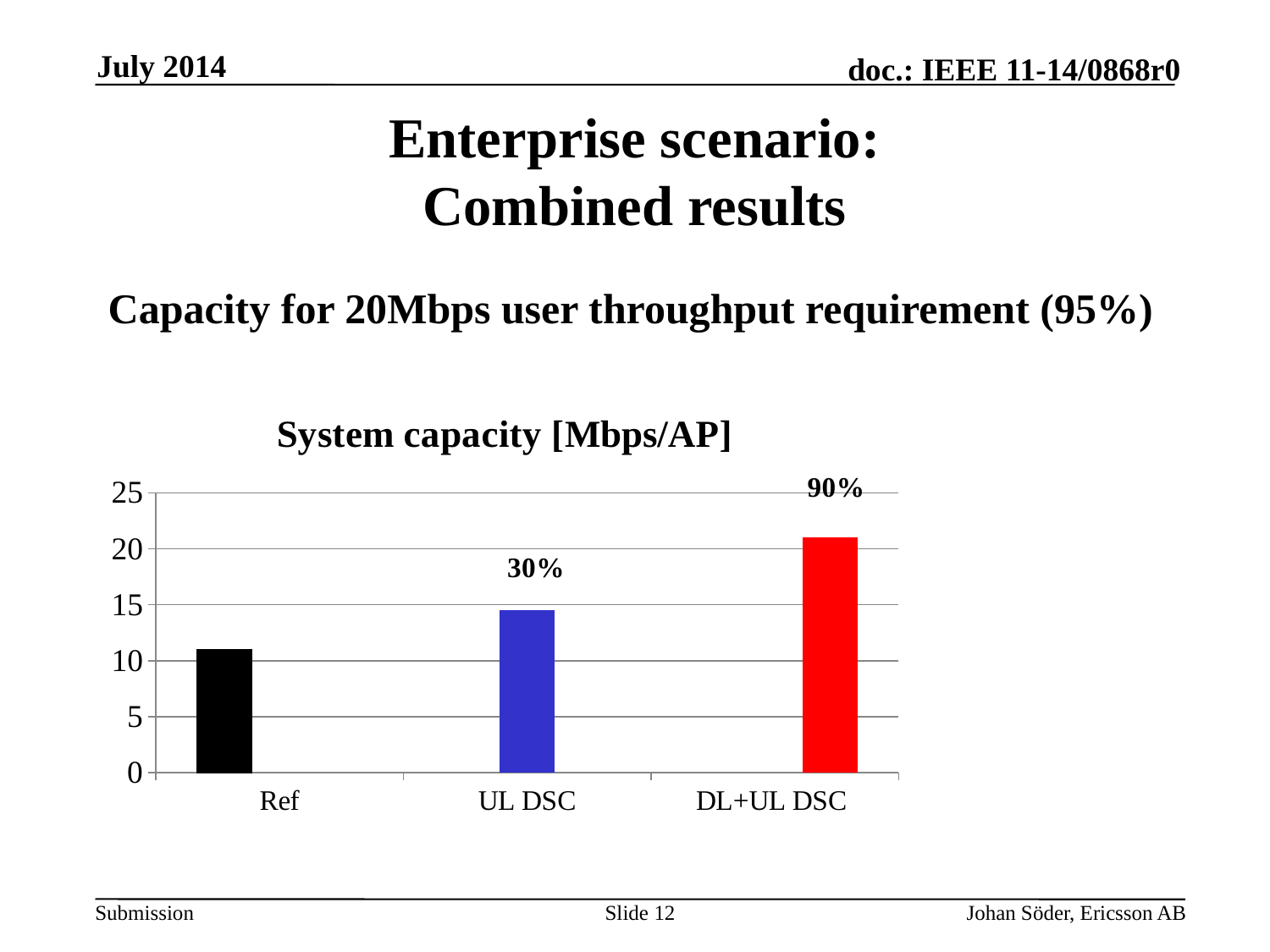
Is the value for Ref greater or less than 15? less What type of chart is shown on the slide? bar chart Is the value for UL DSC greater or less than 10? greater Do the values rise or fall from Ref to DL+UL DSC along the x axis? rise Which category has the highest system capacity? DL+UL DSC What percentage label is printed above the DL+UL DSC bar? 90% What percentage label is printed above the UL DSC bar? 30% How many categories are shown on the x axis of the chart? 3 Which has a larger system capacity, Ref or UL DSC? UL DSC Which category has the lowest system capacity? Ref What is the title of the chart? System capacity [Mbps/AP] Is the value for DL+UL DSC greater or less than 20? greater